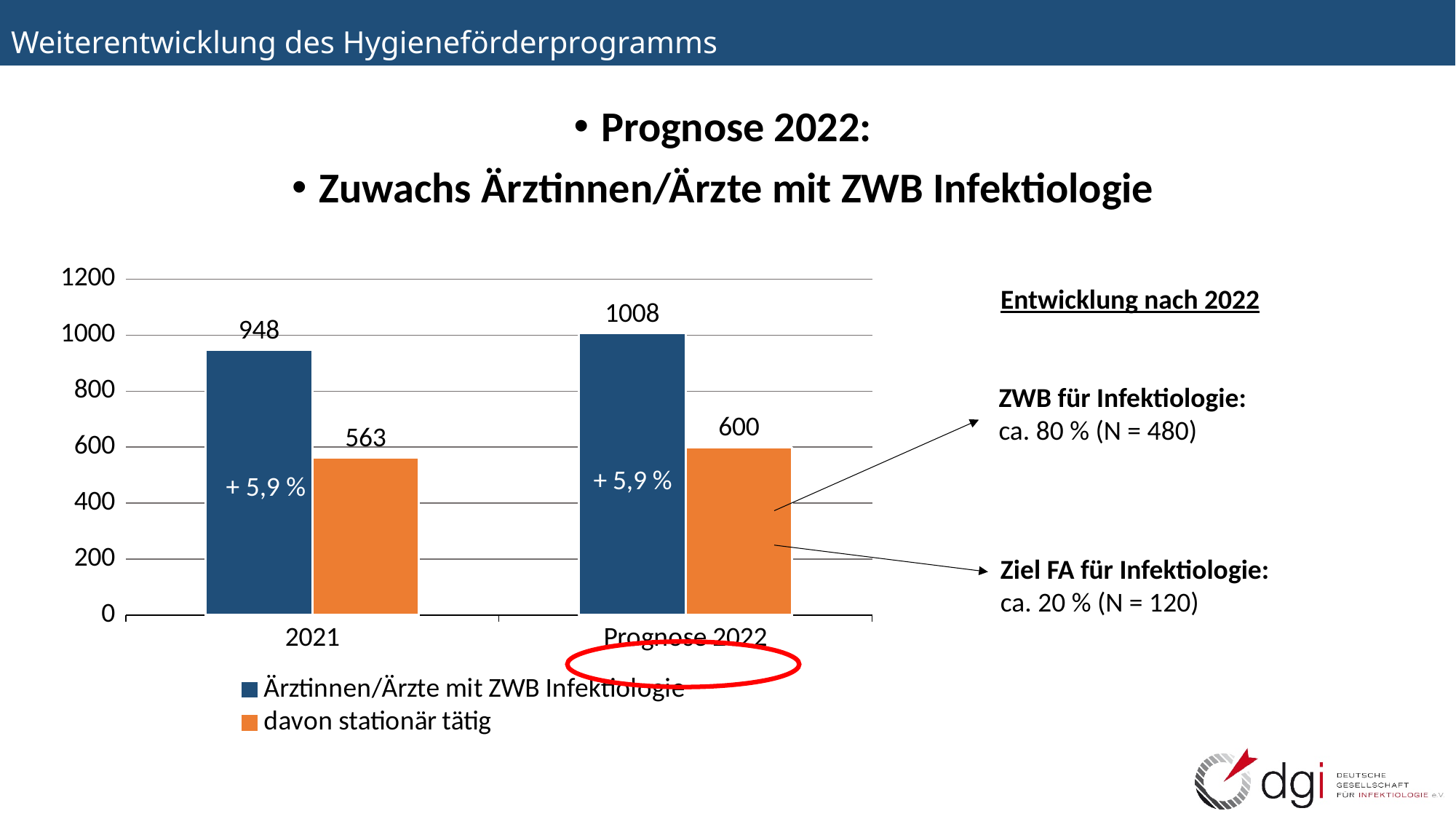
How many series does the legend list? 2 Which category has the highest value for Ärztinnen/Ärzte mit ZWB Infektiologie? Prognose 2022 How many categories are shown on the x axis? 2 What is the difference between Ärztinnen/Ärzte mit ZWB Infektiologie and davon stationär tätig in 2021? 385 What is the difference between Ärztinnen/Ärzte mit ZWB Infektiologie in Prognose 2022 and in 2021? 60 What is the value for davon stationär tätig in 2021? 563 Which is larger: davon stationär tätig in 2021 or in Prognose 2022? Prognose 2022 What is the value for davon stationär tätig in Prognose 2022? 600 What is the value for Ärztinnen/Ärzte mit ZWB Infektiologie in Prognose 2022? 1008 What percentage change is printed inside the blue bars? + 5,9 % What kind of chart is shown on the slide? Bar chart What is the value for Ärztinnen/Ärzte mit ZWB Infektiologie in 2021? 948